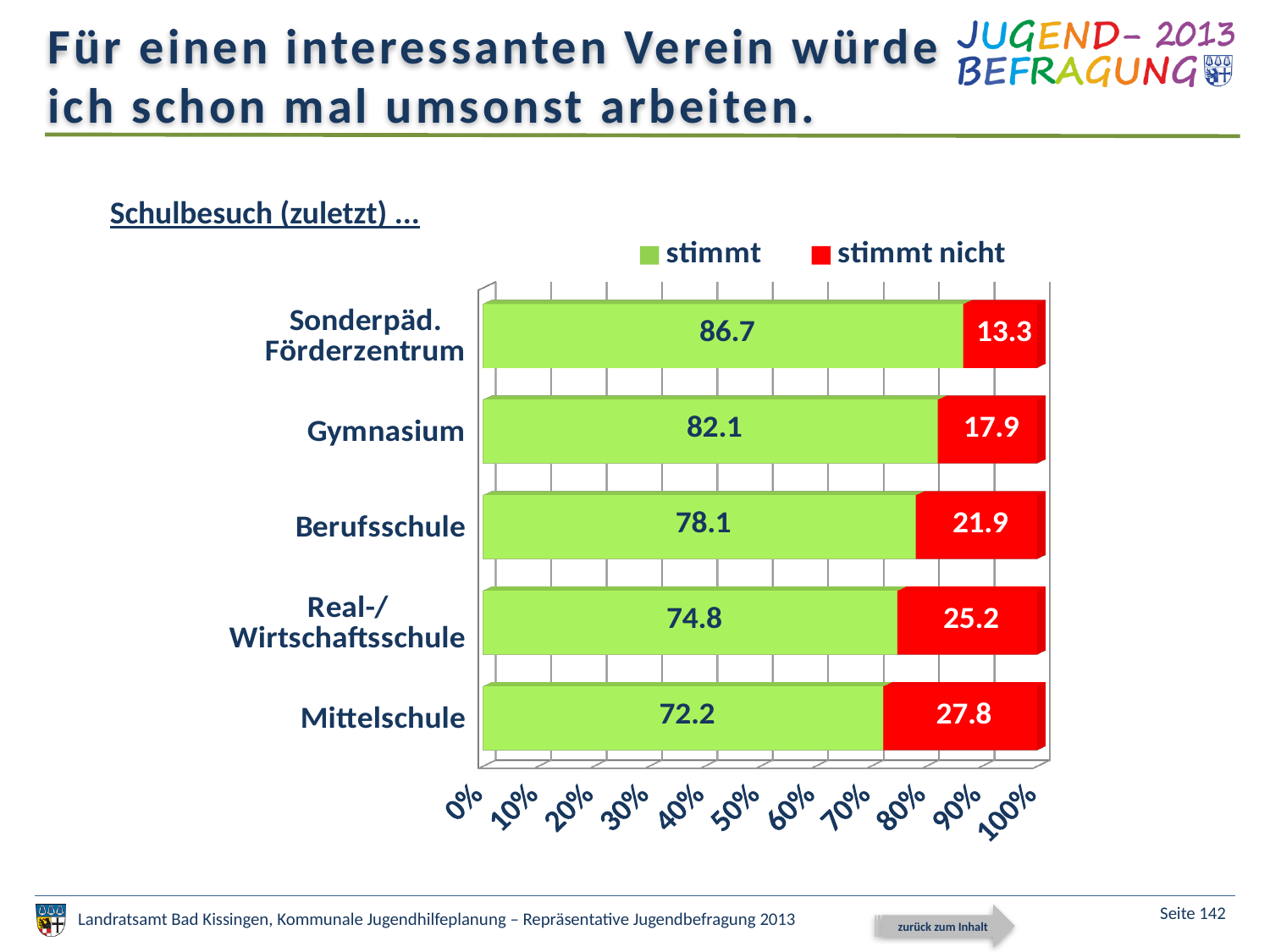
Which school type has the highest 'stimmt' value? Sonderpäd. Förderzentrum Is the 'stimmt' value for Gymnasium greater or less than 80%? greater Which is larger: the 'stimmt nicht' value for Real-/Wirtschaftsschule or for Berufsschule? Real-/Wirtschaftsschule What is the 'stimmt nicht' value for Mittelschule? 27.8 What is the 'stimmt' value for Berufsschule? 78.1 How many series does the legend list? 2 Which school type has the lowest 'stimmt' value? Mittelschule What kind of chart is shown on the slide? Stacked bar chart What is the 'stimmt' value for Gymnasium? 82.1 How many school types are shown in the chart? 5 What is the difference between the 'stimmt' values for Sonderpäd. Förderzentrum and Mittelschule? 14.5 What is the total of the stacked bar for Real-/Wirtschaftsschule? 100